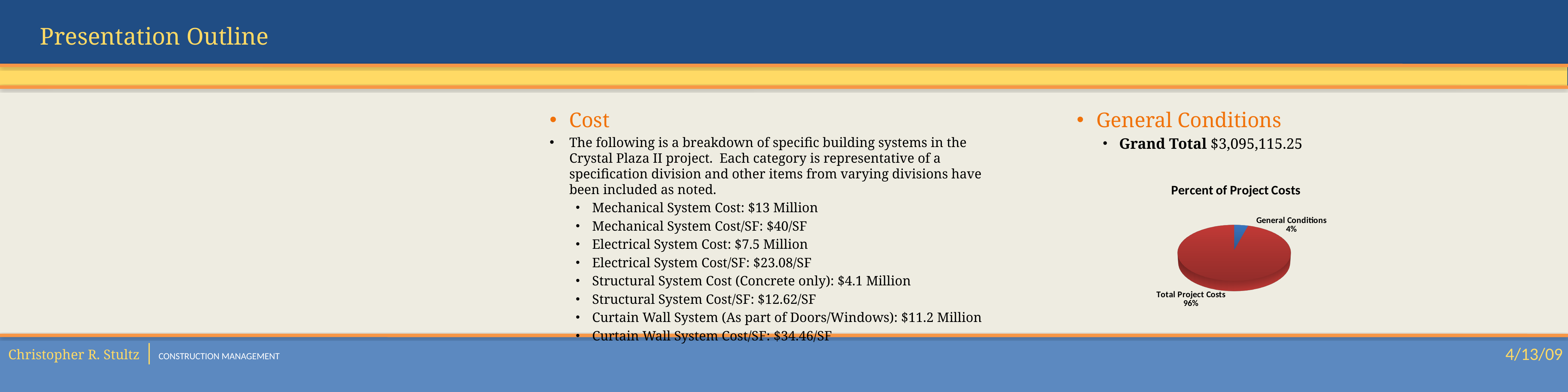
What share of the "Percent of Project Costs" pie does the General Conditions slice represent? 4% In the "Percent of Project Costs" pie chart, what is the difference in percentage points between Total Project Costs and General Conditions? 92 How many slices does the "Percent of Project Costs" pie chart have? 2 Which slice of the "Percent of Project Costs" pie chart is the largest? Total Project Costs In the "Percent of Project Costs" pie chart, what percentage is shown for Total Project Costs? 96% Which slice of the "Percent of Project Costs" pie chart is the smallest? General Conditions What colour is the Total Project Costs slice in the "Percent of Project Costs" pie chart? red What kind of chart is shown under the title "Percent of Project Costs"? pie chart In the "Percent of Project Costs" pie chart, which is larger: General Conditions or Total Project Costs? Total Project Costs In the "Percent of Project Costs" pie chart, what percentage is shown for General Conditions? 4% What is the title of the pie chart on the slide? Percent of Project Costs